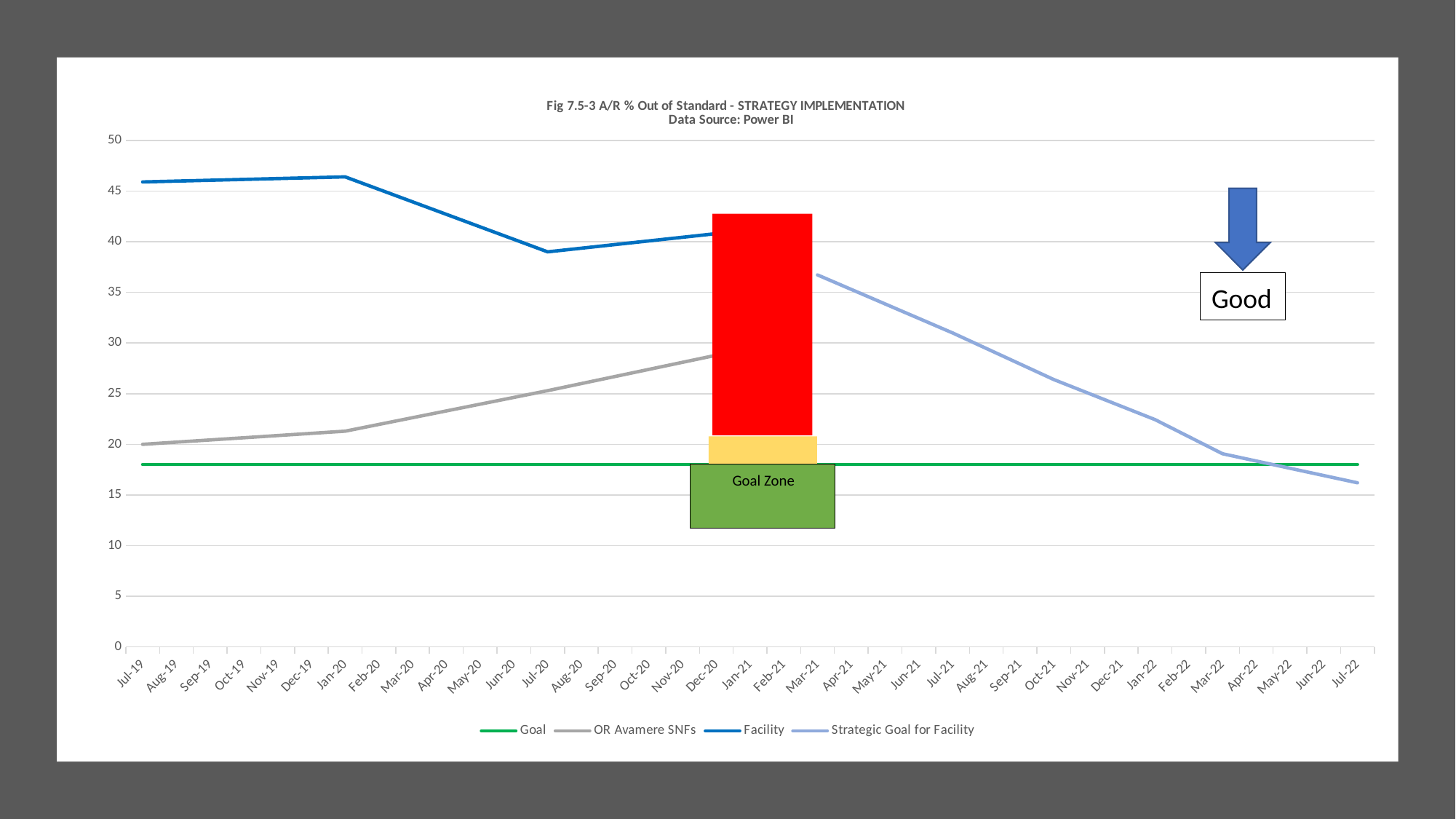
What data source is named in the chart subtitle? Power BI What kind of chart is shown on the slide? Line chart Is the Goal line greater or less than 20? less How many months are labelled on the x axis? 37 Does the Facility line rise or fall between Jan-20 and Jul-20? Fall What is the title of the chart? Fig 7.5-3 A/R % Out of Standard - STRATEGY IMPLEMENTATION Is the OR Avamere SNFs value for Dec-20 greater or less than 25? greater Is the Strategic Goal for Facility value for Jul-22 greater or less than 20? less How many series does the legend list? 4 Does the OR Avamere SNFs line rise or fall between Jul-19 and Dec-20? Rise